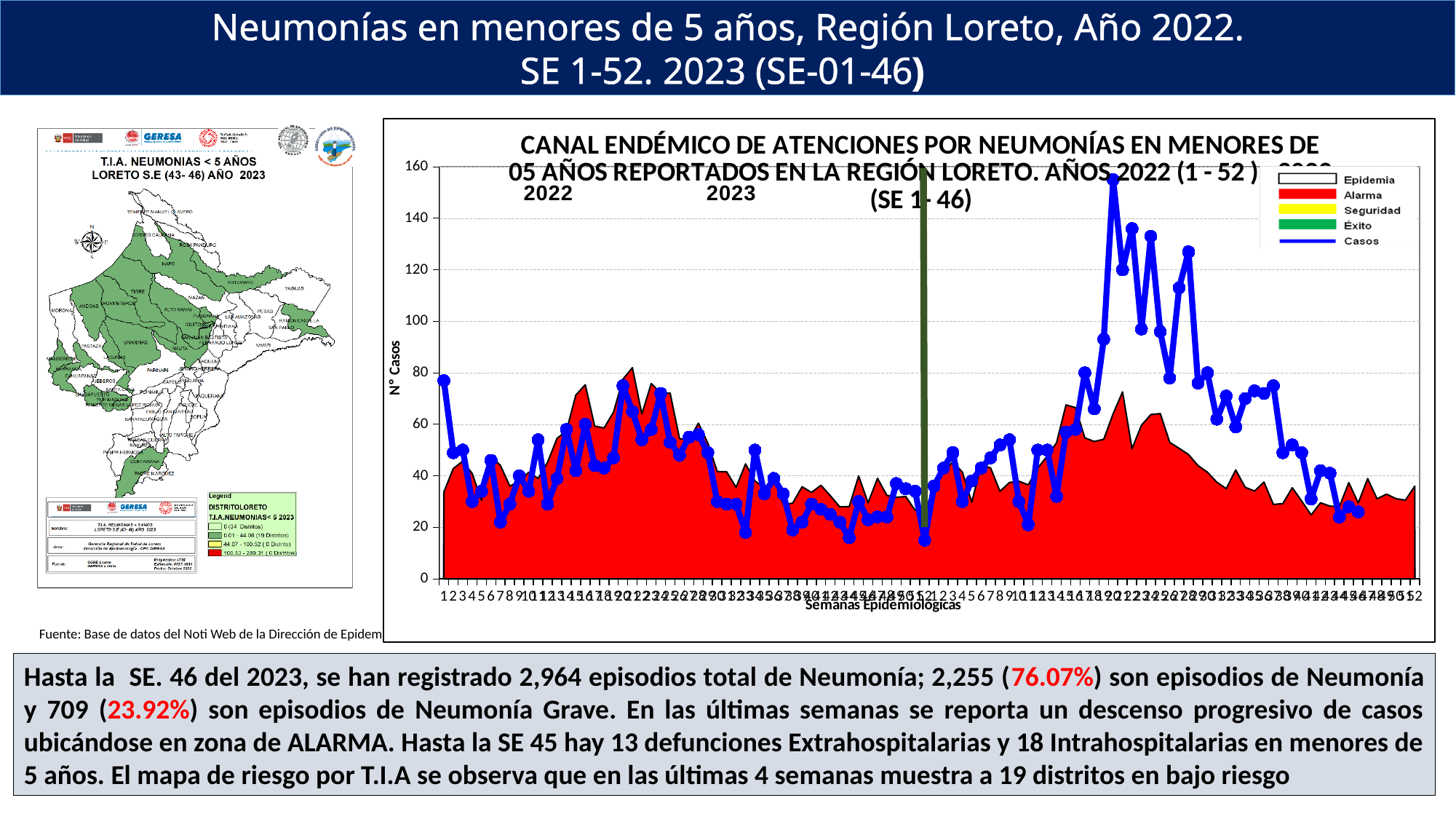
In the endemic channel chart, what colour is the Casos line? Blue In the endemic channel chart, is the value of Casos in week 1 of 2022 larger or smaller than in week 1 of 2023? larger What kind of chart is used to plot the Casos series in the endemic channel chart? line chart In the endemic channel chart, what colour represents the Alarma zone in the legend? Red In the endemic channel chart, do the Casos values rise or fall from the 2023 peak (around week 20) to week 46 of 2023? fall In the endemic channel chart, is the peak value of Casos in 2023 greater or less than 140? greater What is the label of the vertical axis of the endemic channel chart? N° Casos How many series does the legend of the endemic channel chart list? 5 In the endemic channel chart, is the value of Casos in week 1 of 2022 greater or less than 60? greater In the endemic channel chart, is the value of Casos in the last reported week of 2023 (week 46) greater or less than 40? less In the endemic channel chart, which year shows the higher peak of Casos, 2022 or 2023? 2023